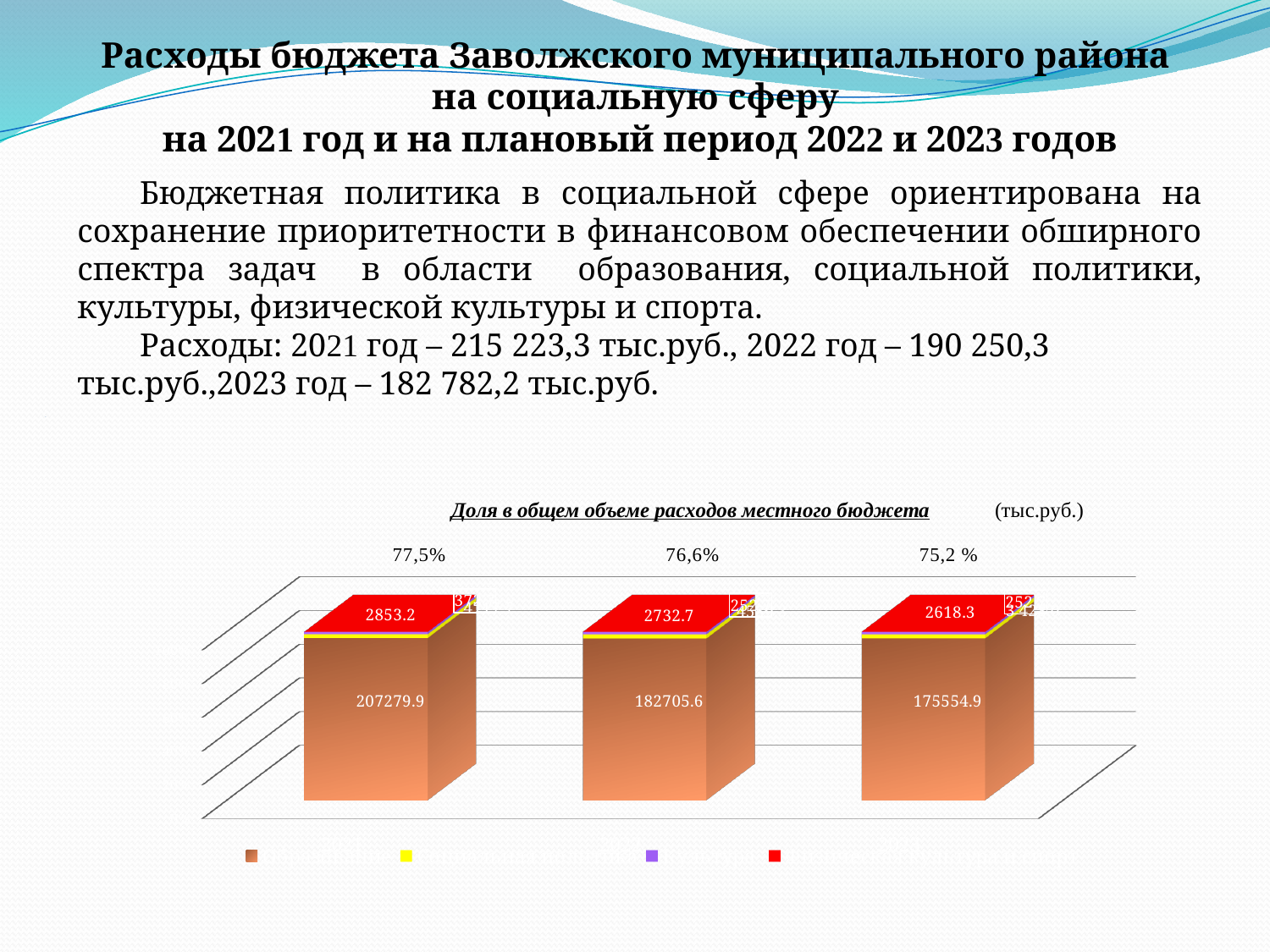
What is the value printed on the large brown segment of the middle bar? 182705.6 What is the value printed on the large brown segment of the right bar? 175554.9 How many bars are plotted in the chart? 3 What kind of chart is shown on the slide? bar chart Do the brown segment values rise or fall from the left bar to the right bar? fall What is the value printed on the large brown segment of the left bar? 207279.9 What is the difference between the brown segment values of the left bar and the middle bar? 24574.3 How many series does the chart legend list? 4 Which bar has the highest value for the brown segment: left, middle or right? left What is the value printed on the red top segment of the right bar? 2618.3 What is the value printed on the red top segment of the left bar? 2853.2 What percentage is printed above the left bar? 77,5%